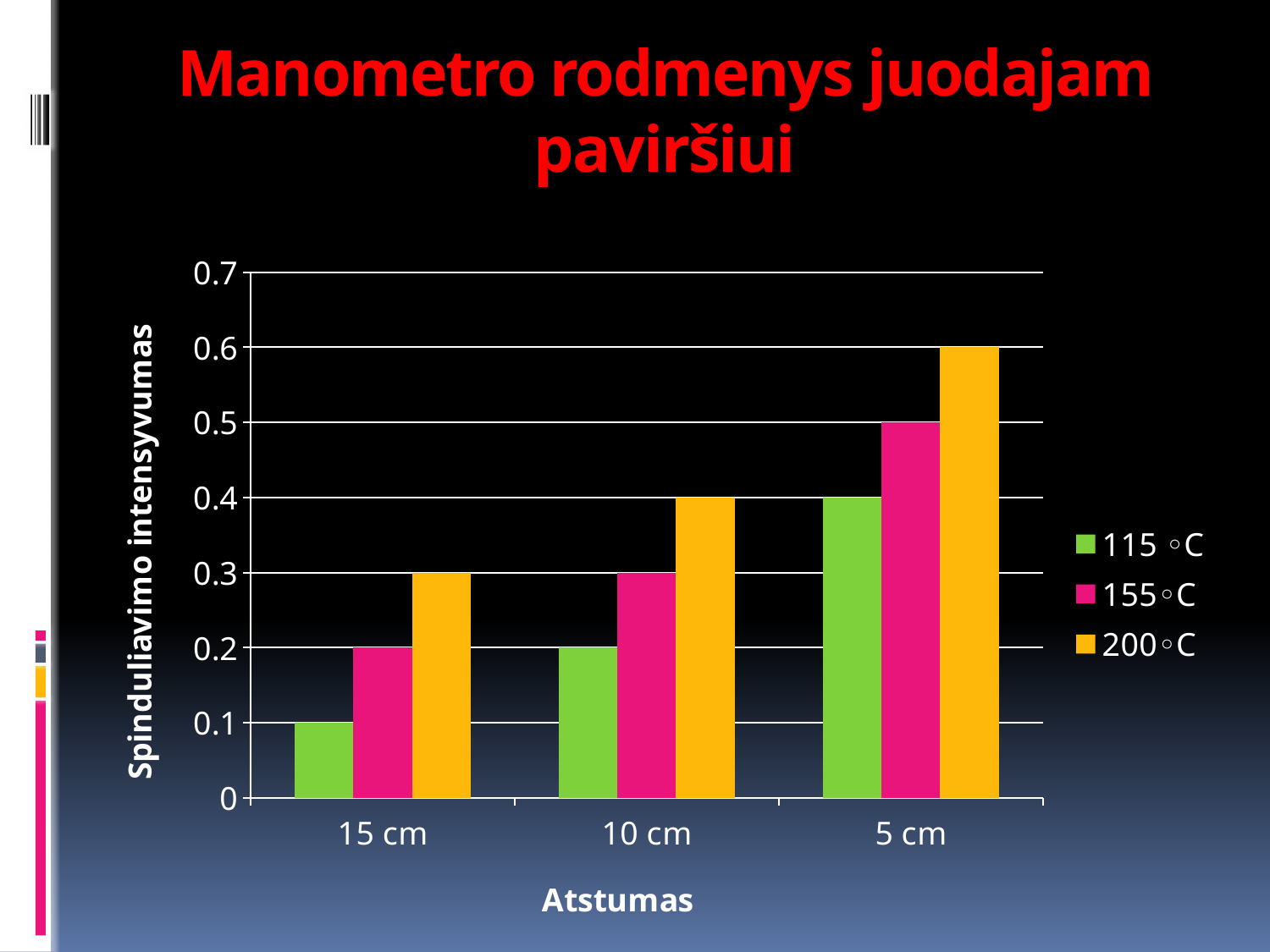
What is the label of the y axis? Spinduliavimo intensyvumas Is the value for 155°C at 5 cm greater or less than 0.4? greater What is the value for 200°C at 5 cm? 0.6 What is the value for 115 °C at 15 cm? 0.1 What kind of chart is shown on the slide? bar chart How many series does the legend list? 3 At which distance is the 200°C series highest? 5 cm What is the value for 155°C at 10 cm? 0.3 Which is larger at 10 cm: the 155°C value or the 200°C value? 200°C What is the difference between the 200°C and 115 °C values at 5 cm? 0.2 How many distance categories are shown on the x axis? 3 At which distance is the 115 °C series lowest? 15 cm